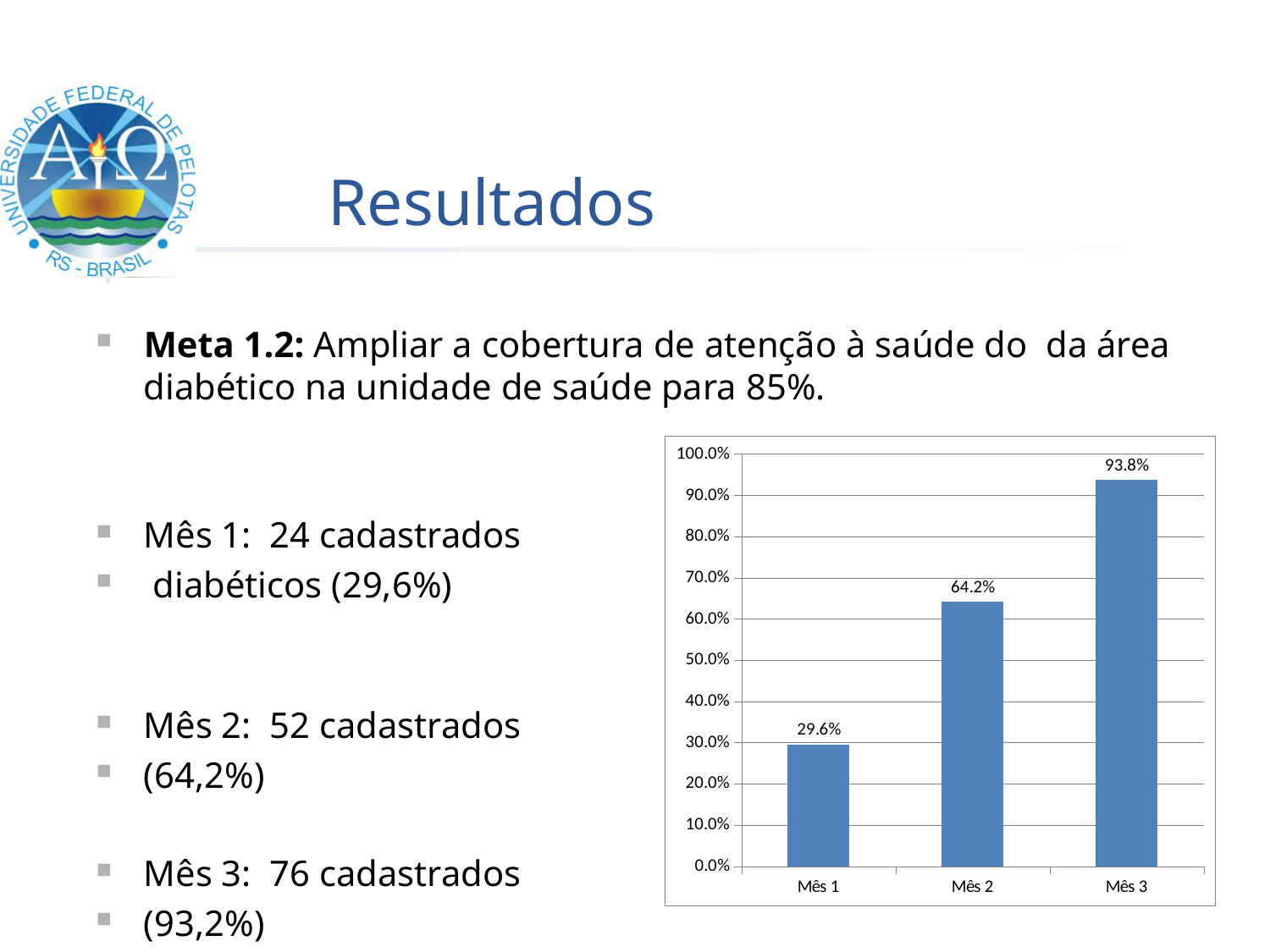
What is the difference between the values for Mês 3 and Mês 2? 29.6% What is the value for Mês 2 in the chart? 64.2% Is the value for Mês 3 greater or less than 90.0%? greater What kind of chart is shown on the slide? bar chart What is the difference between the values for Mês 2 and Mês 1? 34.6% What is the value for Mês 3 in the chart? 93.8% How many categories are shown on the x axis of the chart? 3 Do the values rise or fall from Mês 1 to Mês 3? rise Which is larger, the value for Mês 1 or the value for Mês 2? Mês 2 What is the value for Mês 1 in the chart? 29.6% Which month has the highest value in the chart? Mês 3 Which month has the lowest value in the chart? Mês 1